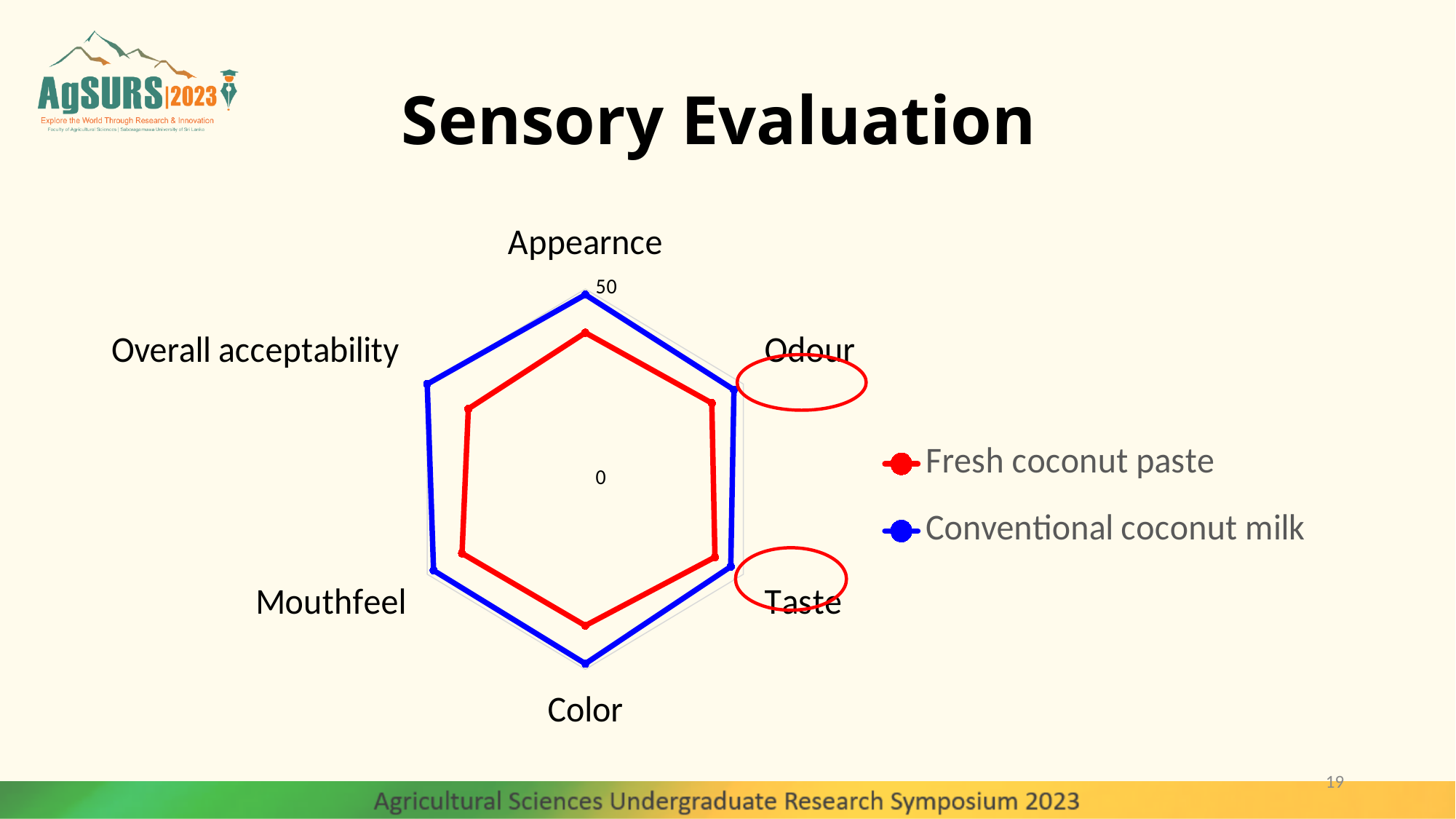
Is the value for Fresh coconut paste at Color greater or less than 50? less What is the title of the chart on the slide? Sensory Evaluation Is the value for Fresh coconut paste at Appearance greater or less than 50? less What kind of chart is shown on the slide? Radar chart How many sensory attributes (axes) are plotted on the chart? 6 Is the value for Fresh coconut paste at Mouthfeel greater or less than 0? greater Which series is larger for Mouthfeel, Fresh coconut paste or Conventional coconut milk? Conventional coconut milk Which colour represents Fresh coconut paste in the chart? Red How many series does the chart legend list? 2 Which series is larger for Taste, Fresh coconut paste or Conventional coconut milk? Conventional coconut milk Which series is larger for Overall acceptability, Fresh coconut paste or Conventional coconut milk? Conventional coconut milk